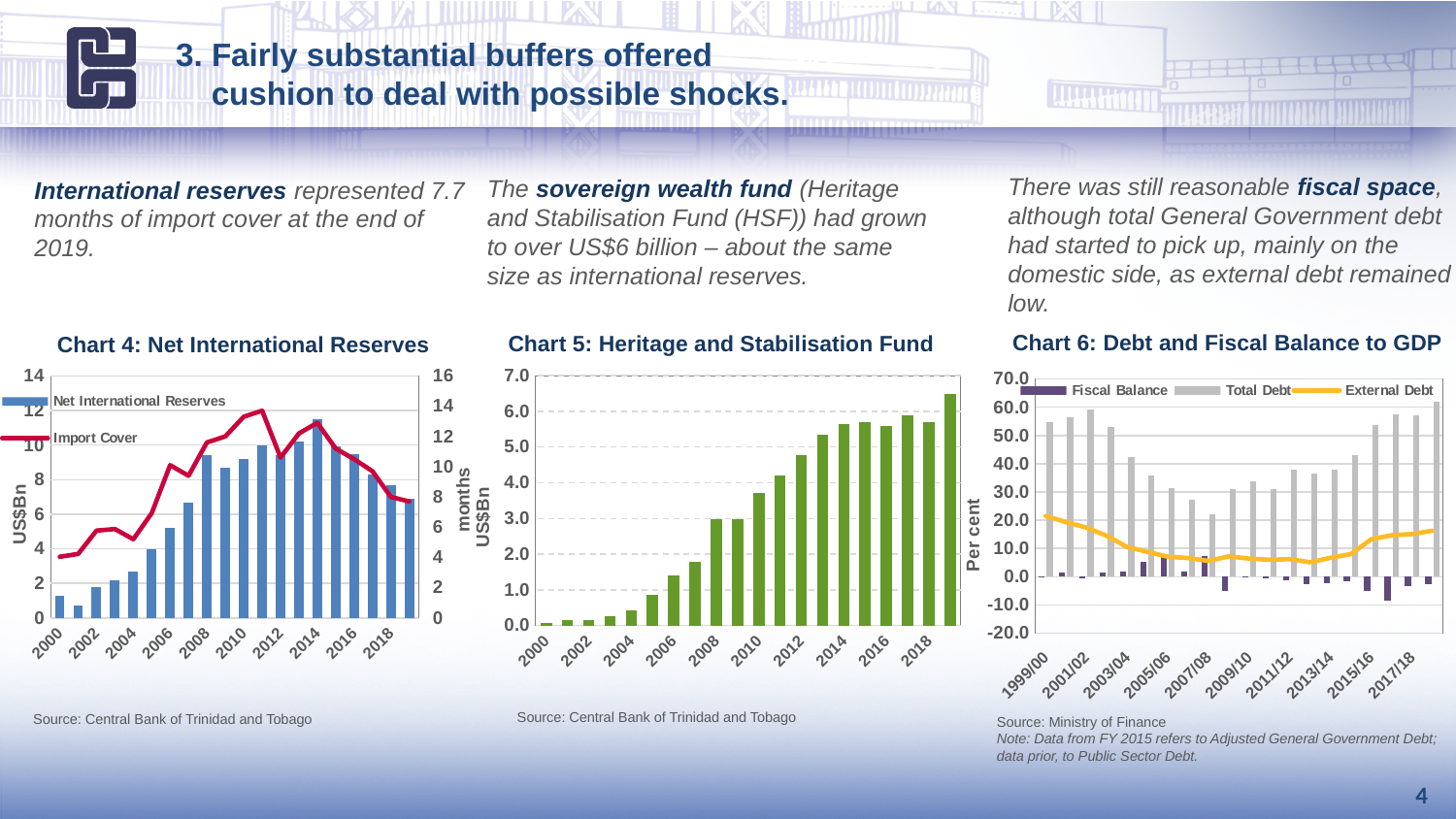
In Chart 5: Heritage and Stabilisation Fund, is the value for 2019 greater or less than 6.0? greater In Chart 5: Heritage and Stabilisation Fund, do the values generally rise or fall from 2000 to 2019? Rise How many series does the legend list in Chart 6: Debt and Fiscal Balance to GDP? 3 In Chart 4: Net International Reserves, which year has the highest Net International Reserves bar? 2014 In Chart 5: Heritage and Stabilisation Fund, is the value for 2012 greater or less than 4.0? greater In Chart 6: Debt and Fiscal Balance to GDP, which series is shown as a yellow line? External Debt In Chart 6: Debt and Fiscal Balance to GDP, is the Total Debt value for 2007/08 greater or less than 30.0? less What kind of chart is Chart 5: Heritage and Stabilisation Fund? Bar chart In Chart 5: Heritage and Stabilisation Fund, which year has the highest value? 2019 In Chart 5: Heritage and Stabilisation Fund, which year has the lowest value? 2000 How many series does the legend list in Chart 4: Net International Reserves? 2